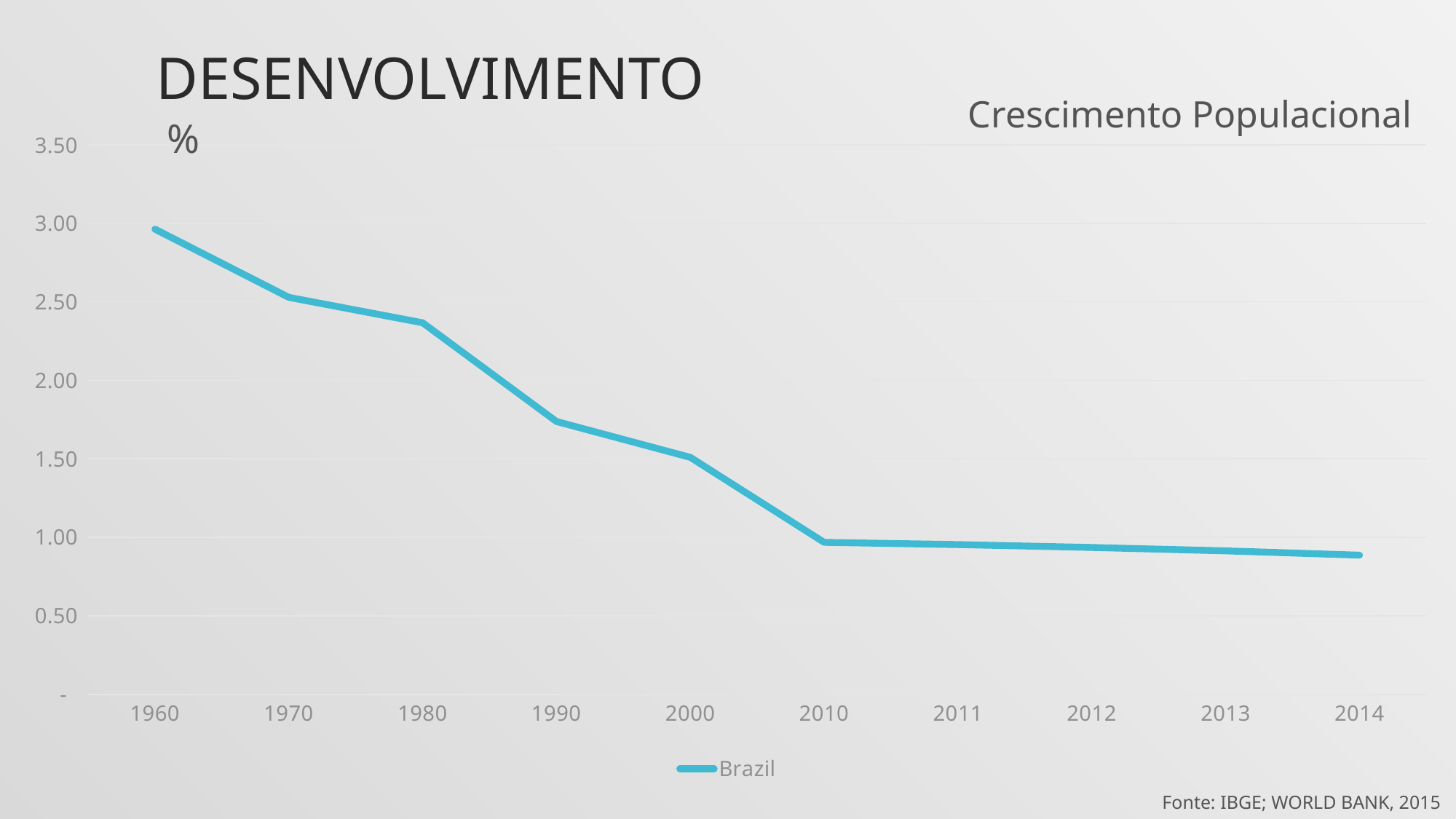
How many series does the legend list? 1 Which year has the highest value for Brazil? 1960 Which year has the lowest value for Brazil? 2014 Is the value for 1960 greater or less than 2.50? greater What is the title of the chart? Crescimento Populacional How many years are plotted along the x axis? 10 Which is larger, the value for 1980 or the value for 2000? 1980 What kind of chart is shown on the slide? line chart Do the values for Brazil rise or fall from 1960 to 2014? fall Is the value for 1990 greater or less than 2.00? less What is the name of the series shown in the legend? Brazil Is the value for 1980 greater or less than 2.00? greater